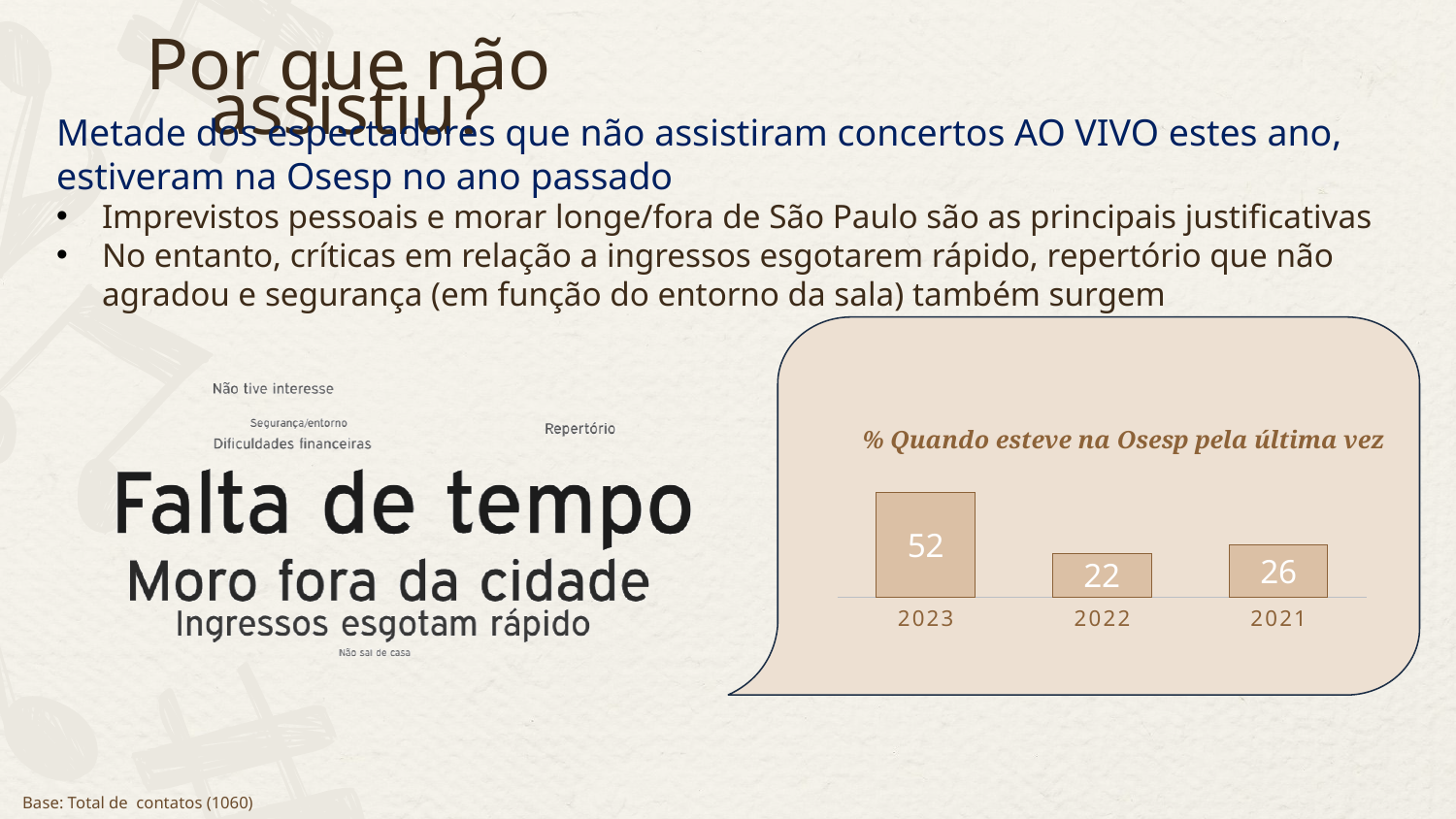
Which year has the lowest value in the chart '% Quando esteve na Osesp pela última vez'? 2022 What is the difference between the values for 2021 and 2022 in the chart '% Quando esteve na Osesp pela última vez'? 4 How many years are shown in the chart '% Quando esteve na Osesp pela última vez'? 3 What kind of chart is '% Quando esteve na Osesp pela última vez'? bar chart In what order are the years listed from left to right on the x axis of the chart '% Quando esteve na Osesp pela última vez'? 2023, 2022, 2021 What is the value for 2023 in the chart '% Quando esteve na Osesp pela última vez'? 52 What is the title of the bar chart on the right side of the slide? % Quando esteve na Osesp pela última vez In the chart '% Quando esteve na Osesp pela última vez', which is larger, the value for 2021 or the value for 2022? 2021 Which year has the highest value in the chart '% Quando esteve na Osesp pela última vez'? 2023 What is the value for 2022 in the chart '% Quando esteve na Osesp pela última vez'? 22 What is the difference between the values for 2023 and 2022 in the chart '% Quando esteve na Osesp pela última vez'? 30 What is the value for 2021 in the chart '% Quando esteve na Osesp pela última vez'? 26